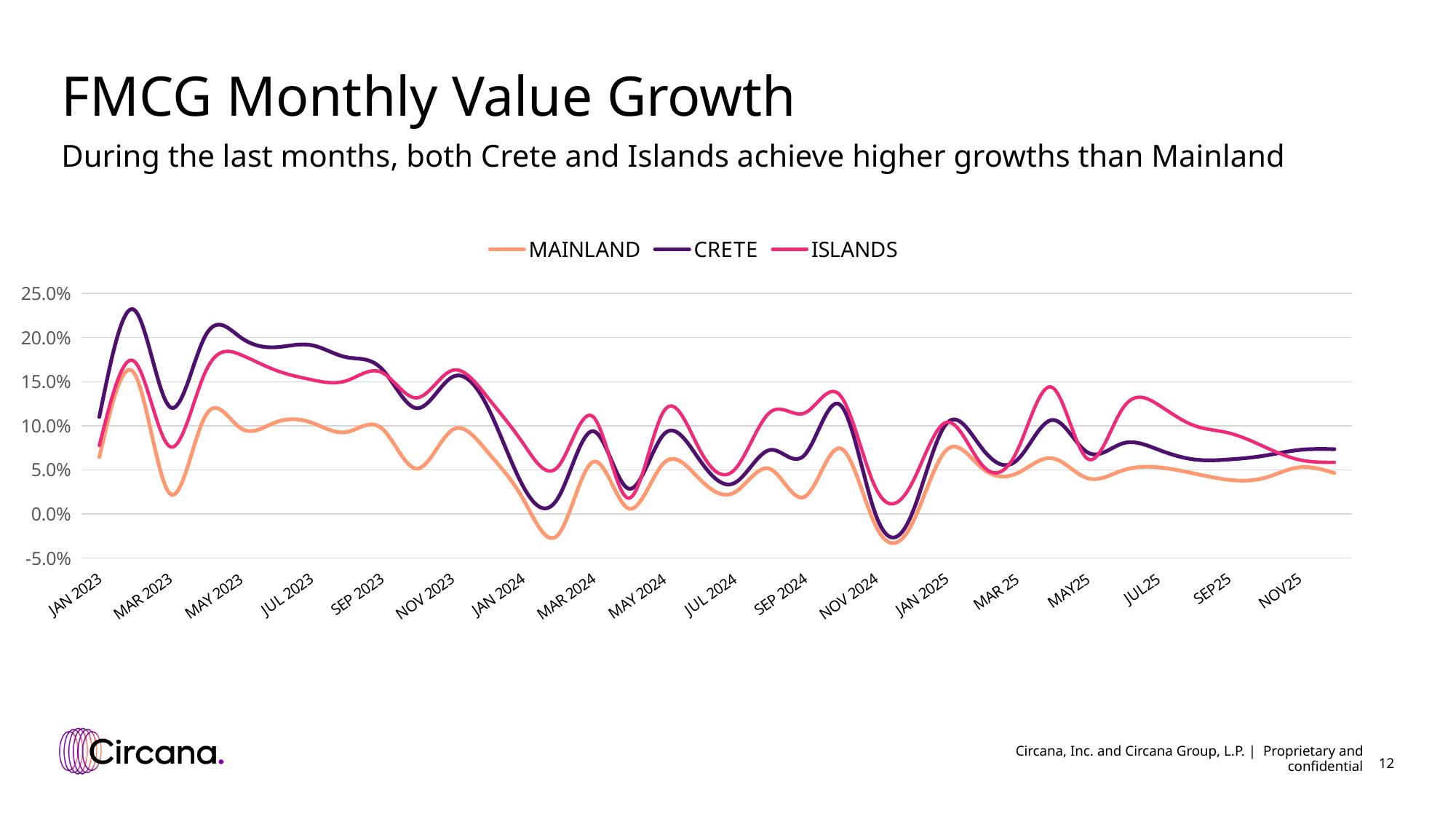
Overall, does the CRETE line rise or fall from JAN 2023 to NOV25? Fall What kind of chart is shown on the slide? Line chart How many series does the legend list? 3 Is the value for ISLANDS at MAY25 greater or less than 10.0%? less At MAY 2023, which series has the larger value, CRETE or MAINLAND? CRETE What is the title of the chart on the slide? FMCG Monthly Value Growth Which series reaches the lowest value anywhere on the chart? MAINLAND Is the value for MAINLAND at MAR 2023 greater or less than 5.0%? less Which series is drawn in orange in the chart? MAINLAND At SEP25, which series has the larger value, ISLANDS or MAINLAND? ISLANDS Which series reaches the highest value anywhere on the chart? CRETE